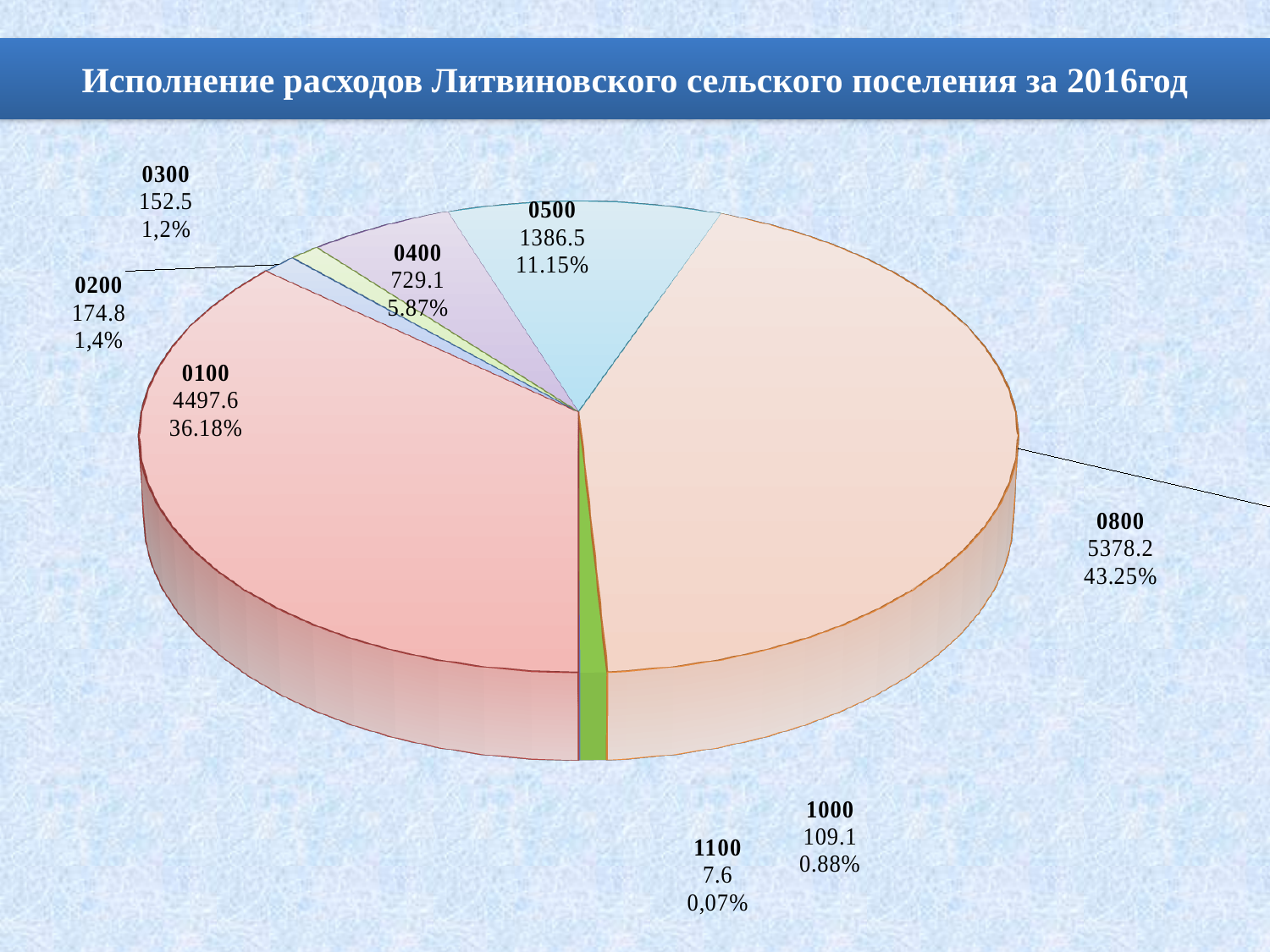
What is the value for category 0500? 1386.5 What share of the pie does category 0400 represent? 5.87% What is the difference between the values for 0800 and 0100? 880.6 What kind of chart is shown on the slide? pie chart What is the value for category 0800? 5378.2 What is the title of the slide? Исполнение расходов Литвиновского сельского поселения за 2016год Which is larger, the value for 0200 or the value for 0300? 0200 How many categories are shown in the pie chart? 8 What share of the pie does category 0100 represent? 36.18% What is the value for category 1000? 109.1 Which category has the smallest slice of the pie? 1100 Which category has the largest slice of the pie? 0800